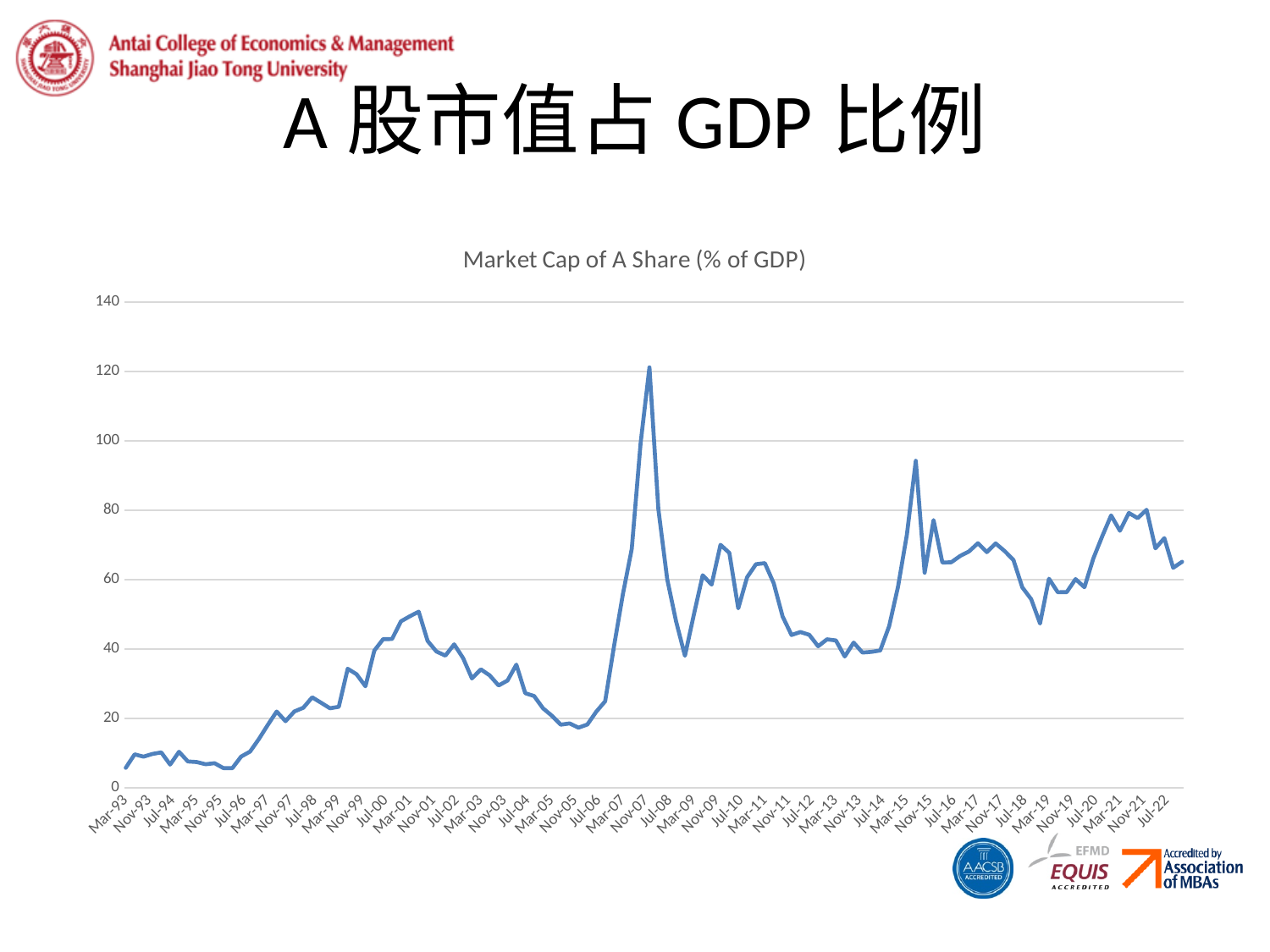
Is the value at Nov-07 greater or less than 100? greater Is the value at Mar-93 greater or less than 20? less Is the value at Jul-14 greater or less than 60? less Which is larger, the value at Nov-07 or the value at Mar-15? Nov-07 Around which x-axis label does the line reach its highest value? Nov-07 How many data series are plotted on the chart? 1 Does the line generally rise or fall from Mar-93 to Mar-01? rise What kind of chart is shown on the slide? line chart What is the title of the chart? Market Cap of A Share (% of GDP)